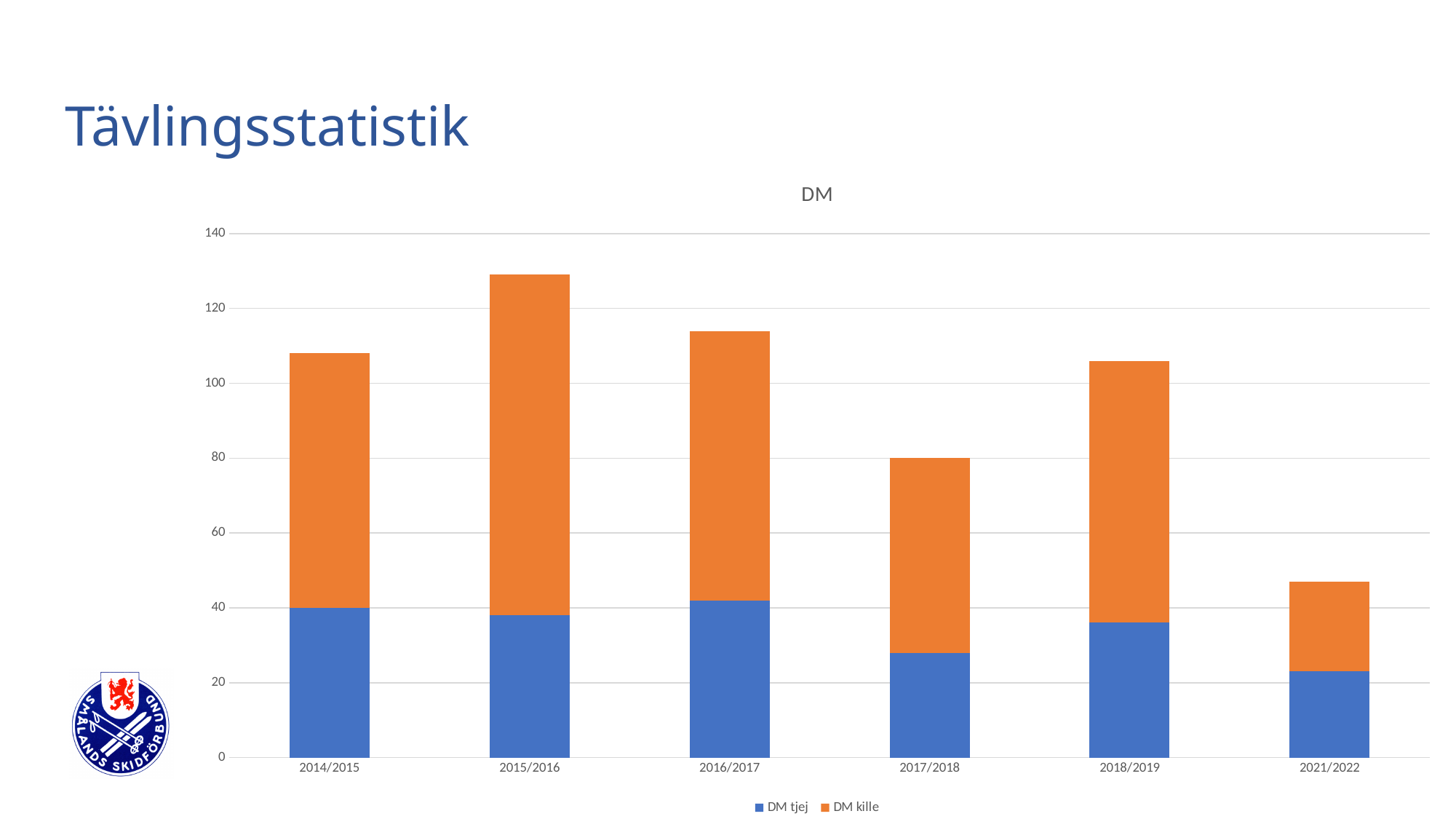
Which total is larger, 2015/2016 or 2016/2017? 2015/2016 Which season has the lowest total bar? 2021/2022 Which colour represents DM kille in the chart? orange Is the DM tjej value for 2017/2018 greater or less than 40? less What kind of chart is shown on the slide? stacked bar chart How many seasons are shown on the x axis? 6 Which season has the highest total bar? 2015/2016 Is the total for 2021/2022 greater or less than 60? less How many series does the legend list? 2 Which total is larger, 2017/2018 or 2021/2022? 2017/2018 What is the title of the chart? DM Is the total for 2015/2016 greater or less than 120? greater